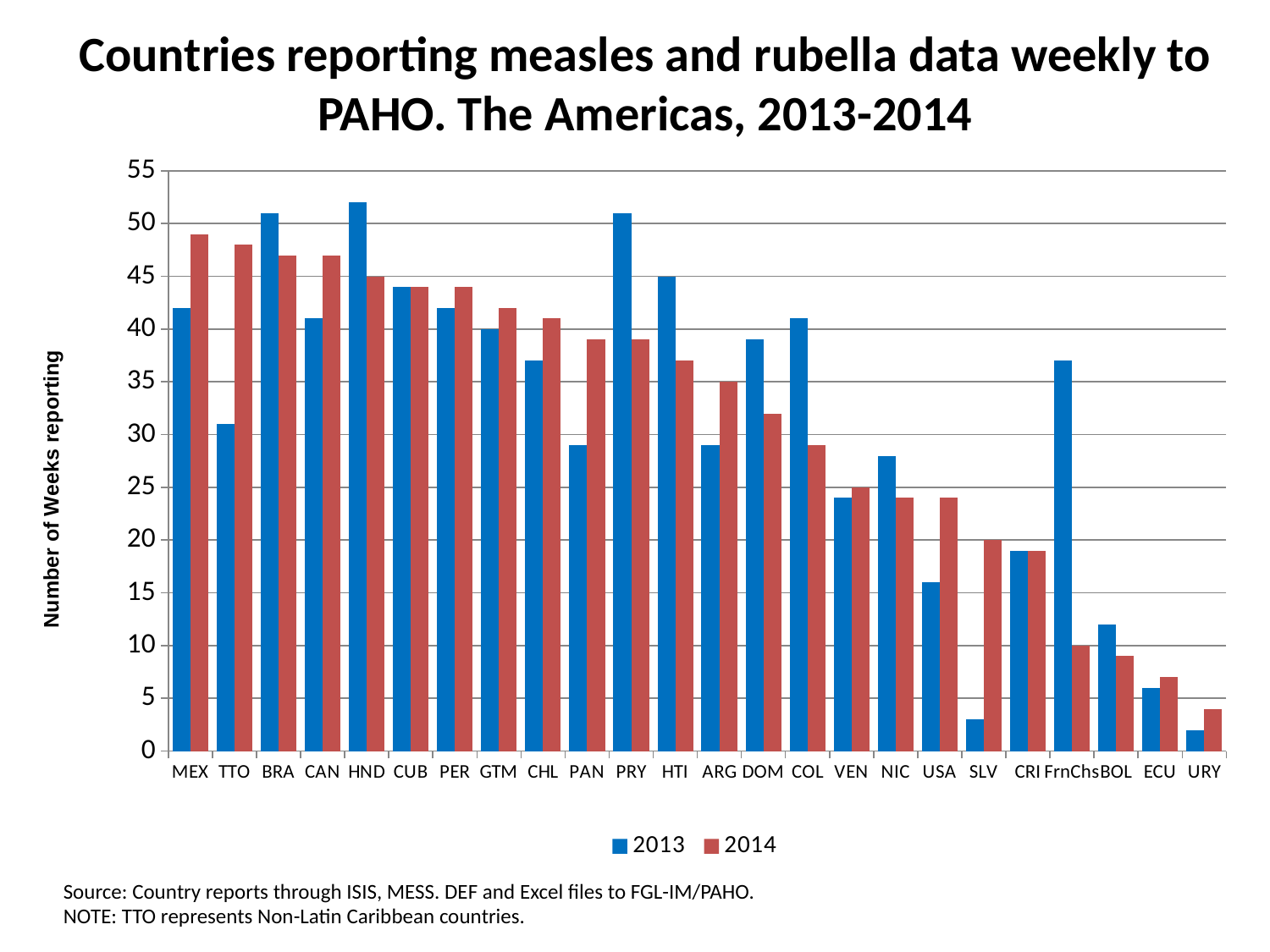
How many countries (categories) are shown on the x axis? 24 For PRY, which is larger: the 2013 value or the 2014 value? 2013 What is the title of the vertical axis? Number of Weeks reporting For TTO, which is larger: the 2013 value or the 2014 value? 2014 How many series does the legend list? 2 For FrnChs, which is larger: the 2013 value or the 2014 value? 2013 What kind of chart is shown on the slide? bar chart Is the 2013 value for HND greater or less than 50? greater Is the 2014 value for COL greater or less than 30? less Is the 2013 value for SLV greater or less than 5? less Which country has the lowest value for 2013? URY Which country has the lowest value for 2014? URY